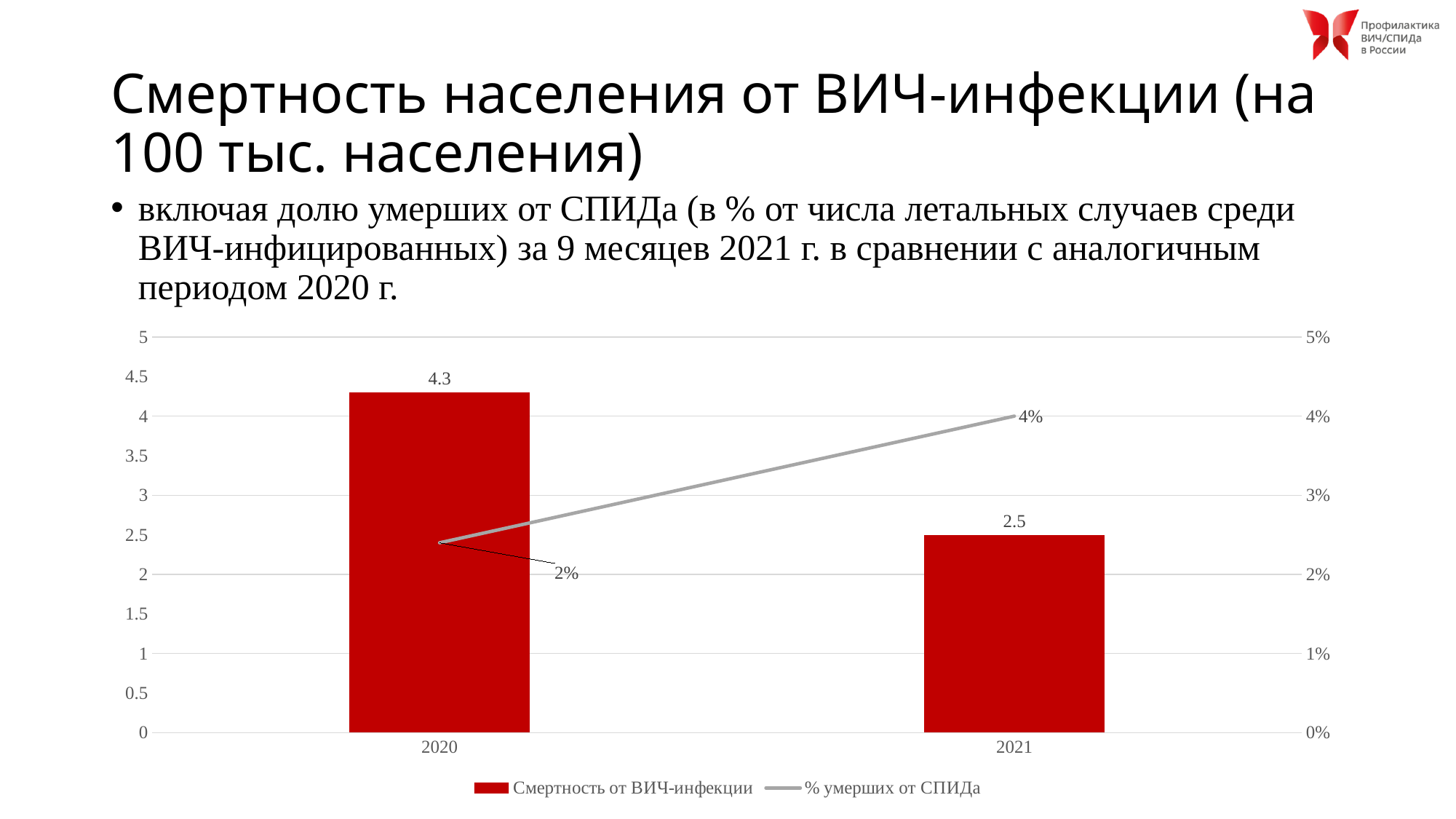
What is the value of % умерших от СПИДа for 2021? 4% What colour are the bars for Смертность от ВИЧ-инфекции? red How many series does the legend list? 2 What is the value of Смертность от ВИЧ-инфекции for 2020? 4.3 Is the Смертность от ВИЧ-инфекции value for 2021 greater or less than 3? less Does the Смертность от ВИЧ-инфекции series rise or fall from 2020 to 2021? fall Which year has the higher value of Смертность от ВИЧ-инфекции? 2020 What is the value of Смертность от ВИЧ-инфекции for 2021? 2.5 What is the value of % умерших от СПИДа for 2020? 2% What is the difference between the Смертность от ВИЧ-инфекции values for 2020 and 2021? 1.8 Which year has the lower value of % умерших от СПИДа? 2020 How many categories are shown on the x axis? 2